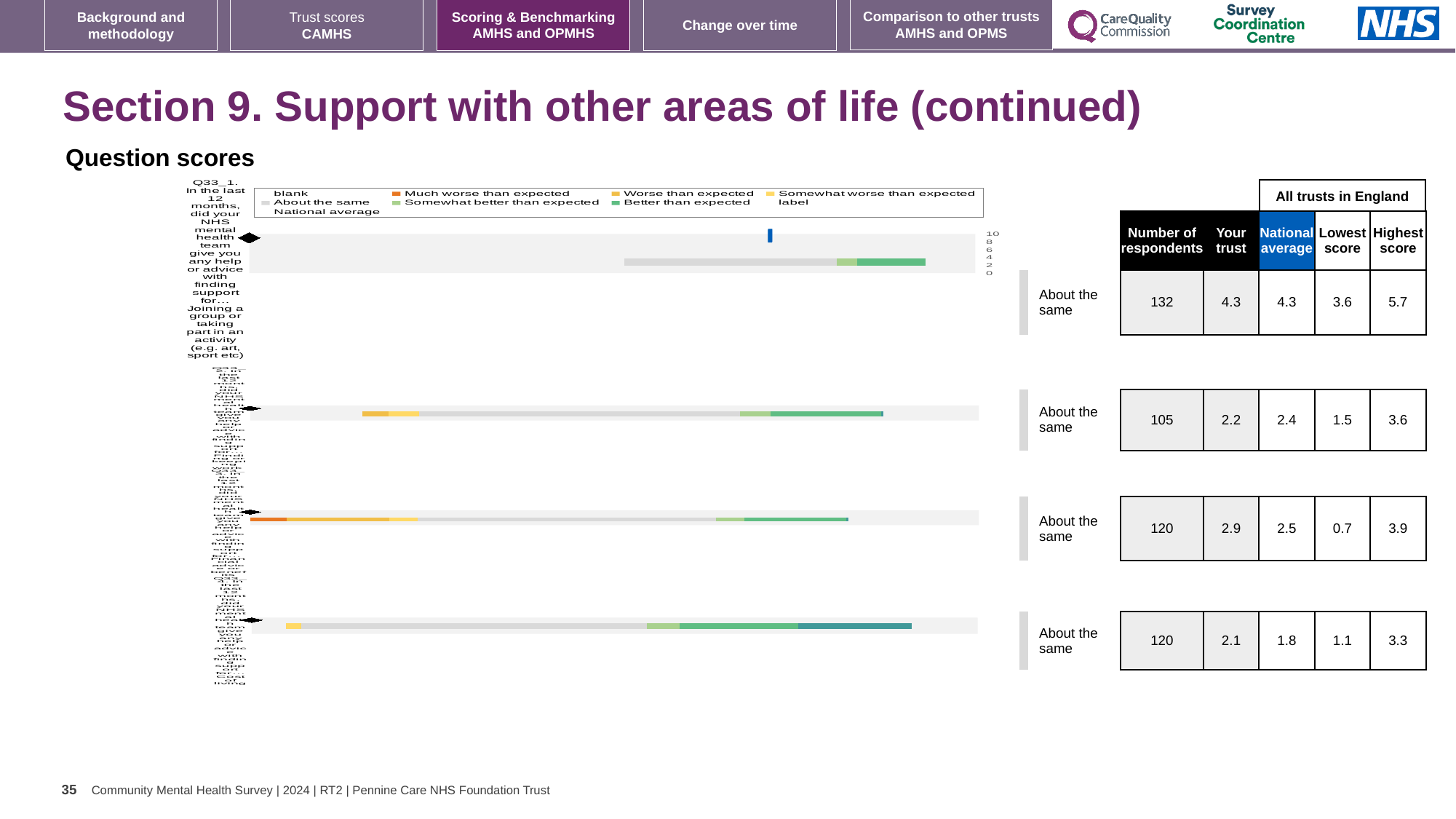
What kind of chart is shown on the slide? bar chart Which legend entry is shown in dark green in the chart? Better than expected How many entries does the chart legend list? 9 What is the highest tick value shown on the chart's axis? 10 Which legend entry is shown in orange in the chart? Much worse than expected How many horizontal bars are plotted in the chart? 4